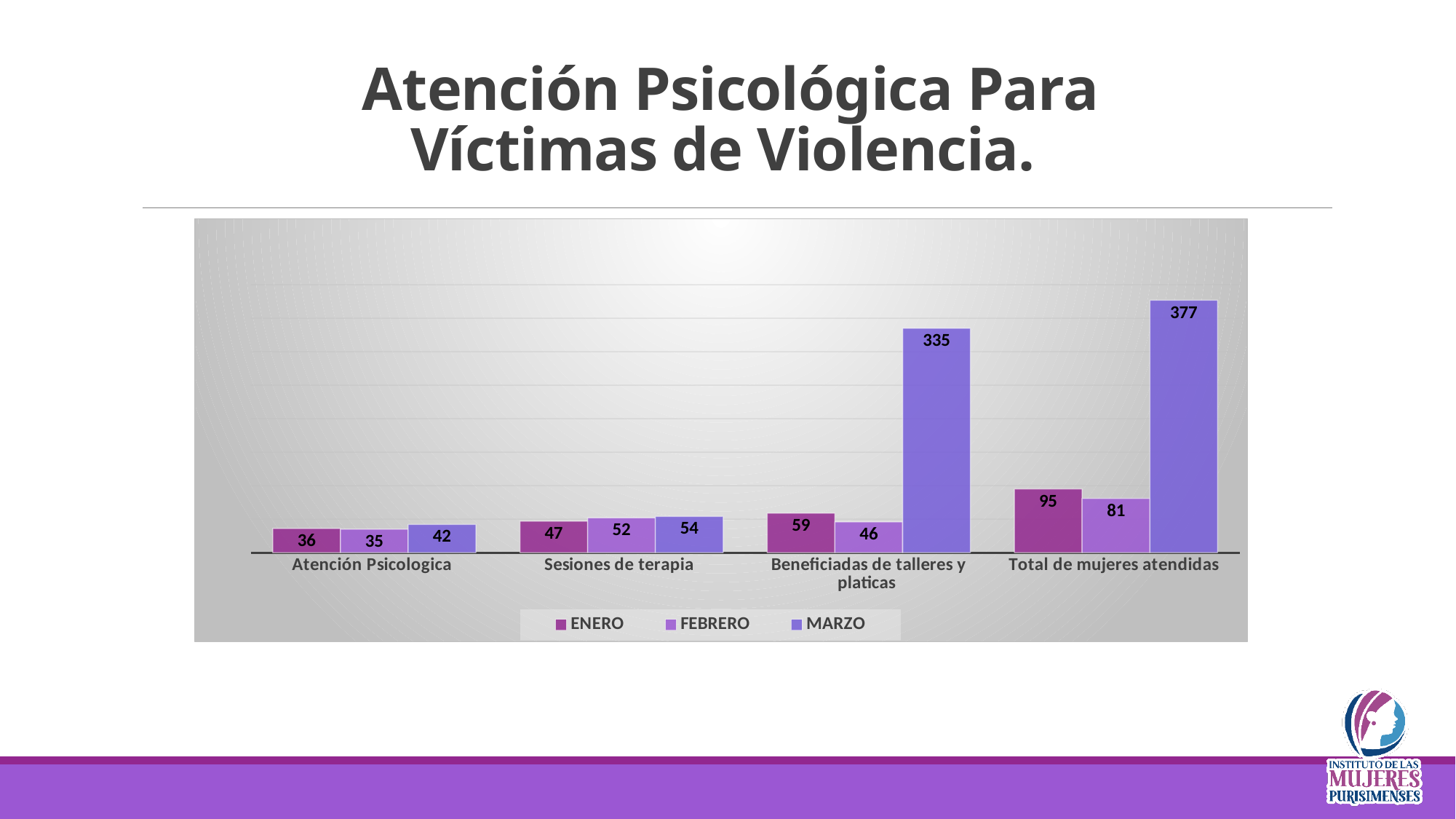
What is the FEBRERO value for Total de mujeres atendidas? 81 What is the MARZO value for Sesiones de terapia? 54 What are the three series listed in the legend? ENERO, FEBRERO, MARZO What is the MARZO value for Beneficiadas de talleres y platicas? 335 How many series does the legend list? 3 Which is larger for Beneficiadas de talleres y platicas: the ENERO value or the FEBRERO value? ENERO What is the ENERO value for Atención Psicologica? 36 Which category has the lowest FEBRERO value? Atención Psicologica How many categories are shown on the x axis? 4 What kind of chart is shown on the slide? Bar chart Which category has the highest MARZO value? Total de mujeres atendidas What is the difference between the MARZO and ENERO values for Total de mujeres atendidas? 282